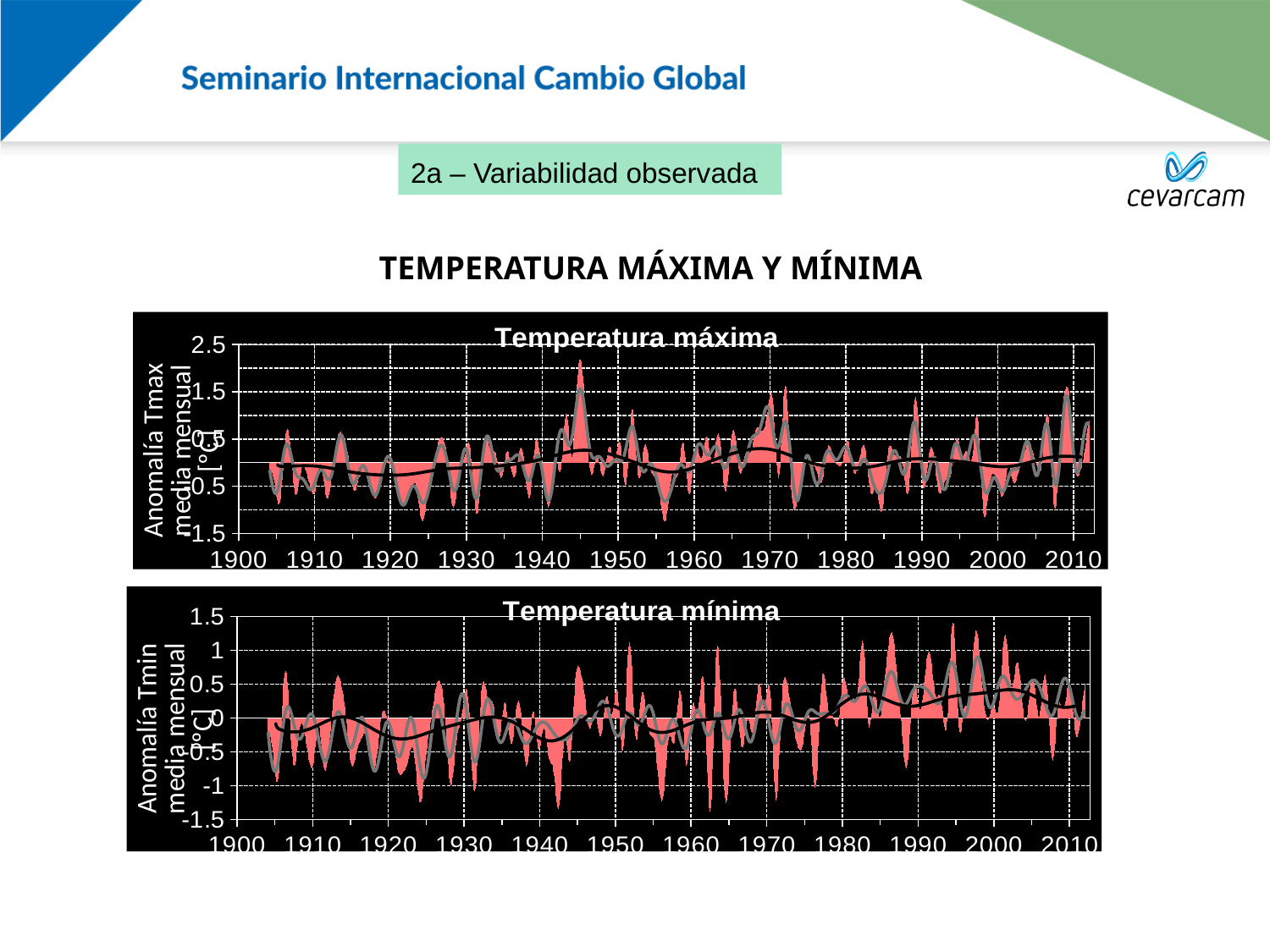
What is the first year shown on the x axis of the Temperatura máxima chart? 1900 In the Temperatura máxima chart, is the smoothed black line higher around 1990 or around 1925? around 1990 Is the top chart a bar chart or a line chart? line chart In the Temperatura mínima chart, does the smoothed black line rise or fall from 1900 to 2010? rises In the Temperatura mínima chart, is the smoothed black line higher around 2000 or around 1920? around 2000 In the Temperatura máxima chart, is the lowest value around 1957 greater or less than -0.5? less What is the title of the bottom chart? Temperatura mínima What is the title of the top chart? Temperatura máxima In the Temperatura máxima chart, is the peak value around 1945 greater or less than 1.5? greater In the Temperatura mínima chart, is the lowest value around 1943 greater or less than -1? less How many charts are shown on the slide? 2